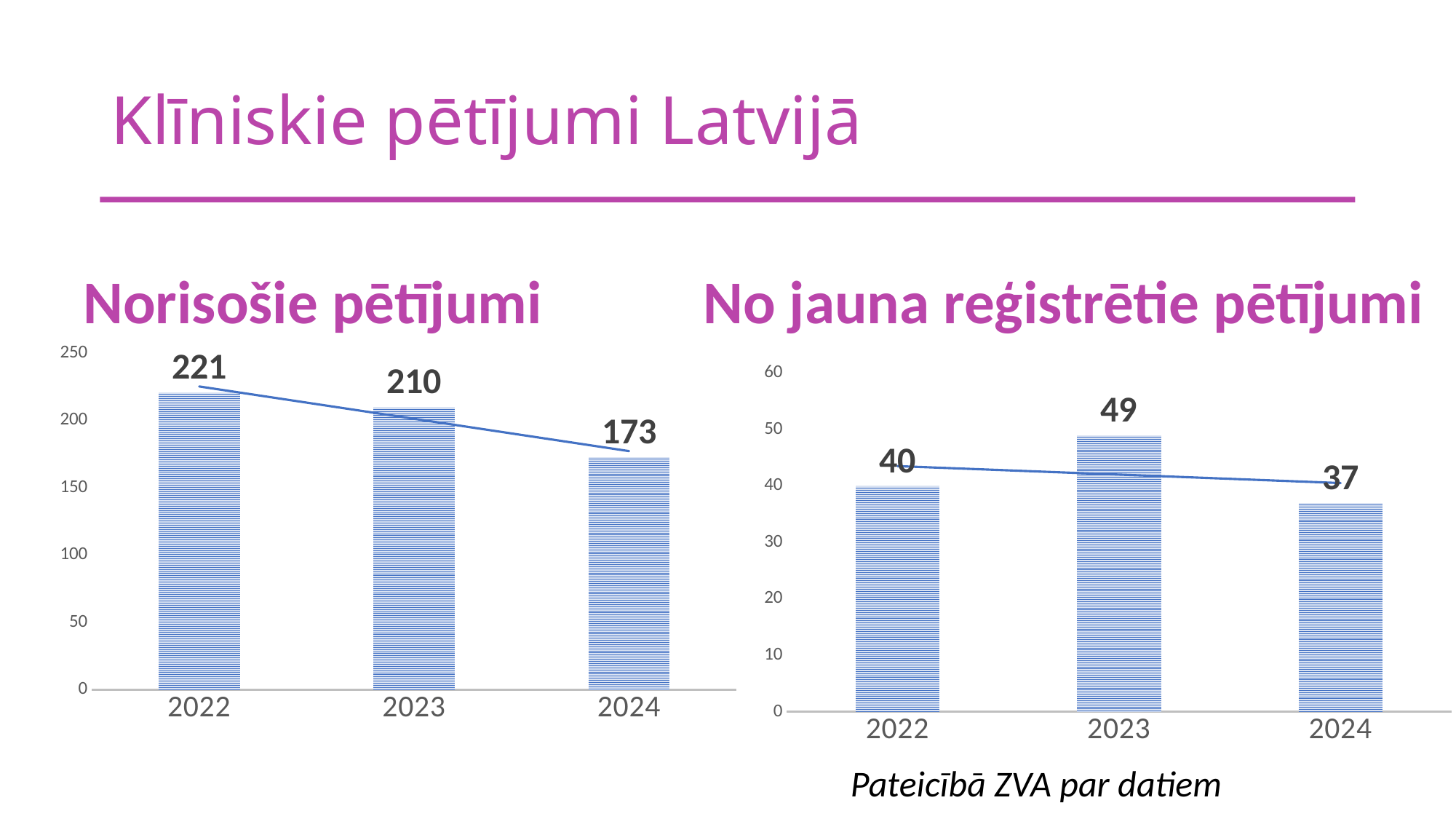
In the 'Norisošie pētījumi' chart, do the values rise or fall from 2022 to 2024? Fall In the 'No jauna reģistrētie pētījumi' chart, which is larger, the value for 2022 or 2024? 2022 In the 'No jauna reģistrētie pētījumi' chart, what is the value for 2024? 37 In the 'No jauna reģistrētie pētījumi' chart, what is the value for 2023? 49 In the 'No jauna reģistrētie pētījumi' chart, which year has the lowest value? 2024 In the 'Norisošie pētījumi' chart, what is the value for 2024? 173 How many years are shown in the 'Norisošie pētījumi' chart? 3 In the 'No jauna reģistrētie pētījumi' chart, what is the difference between the values for 2023 and 2022? 9 What kind of chart is the 'Norisošie pētījumi' chart? Bar chart In the 'Norisošie pētījumi' chart, what is the difference between the values for 2022 and 2024? 48 In the 'Norisošie pētījumi' chart, which year has the highest value? 2022 In the 'Norisošie pētījumi' chart, what is the value for 2022? 221